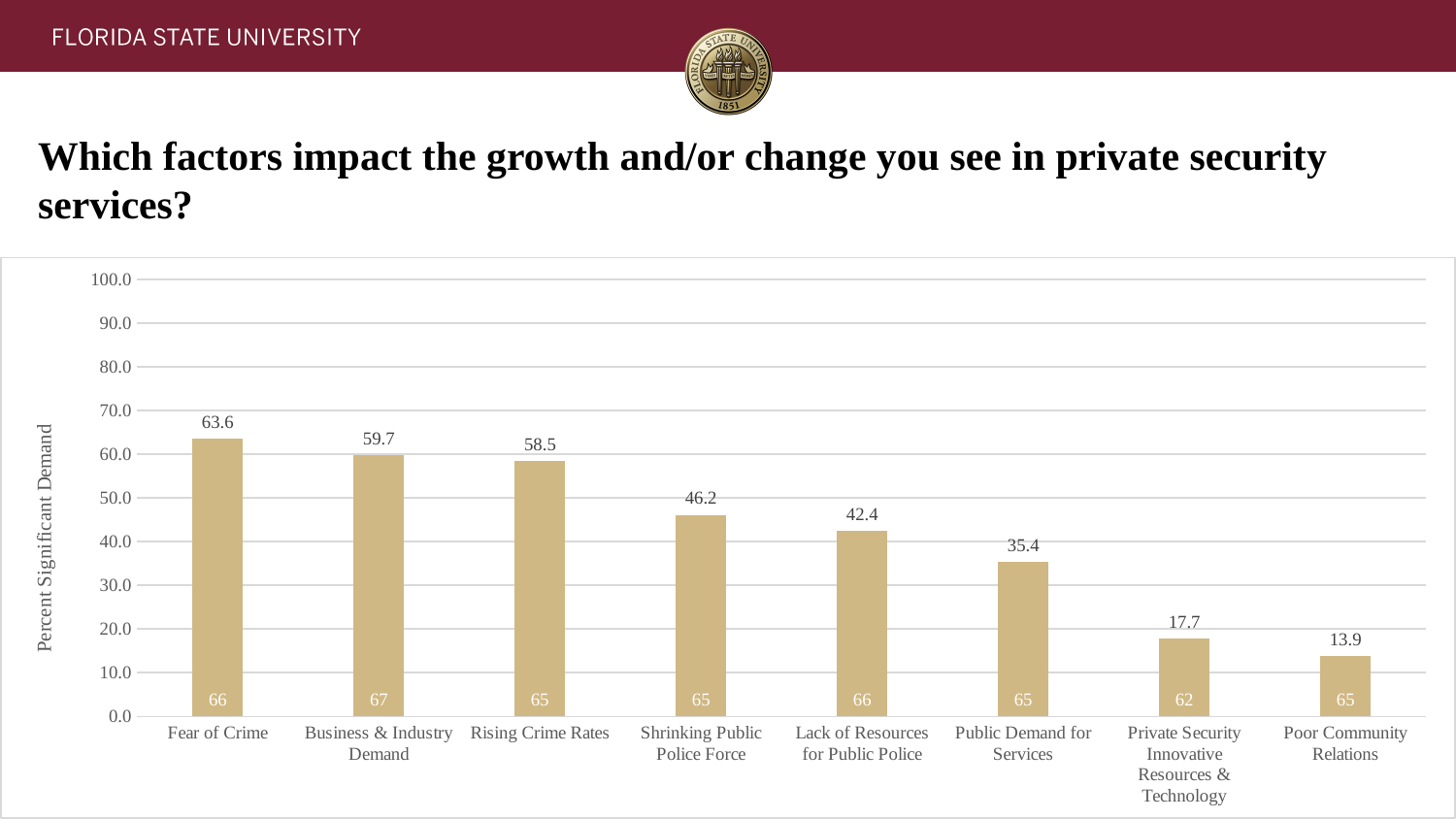
What is the difference between the values for Fear of Crime and Business & Industry Demand? 3.9 How many categories are shown on the chart? 8 What kind of chart is shown on the slide? bar chart Is the value for Public Demand for Services greater or less than 40.0? less What is the label of the vertical axis? Percent Significant Demand Which category has the highest value? Fear of Crime What is the difference between the values for Lack of Resources for Public Police and Public Demand for Services? 7.0 What is the value for Private Security Innovative Resources & Technology? 17.7 What is the value for Shrinking Public Police Force? 46.2 Which is larger, the value for Rising Crime Rates or the value for Shrinking Public Police Force? Rising Crime Rates Which category has the lowest value? Poor Community Relations What is the value for Fear of Crime? 63.6